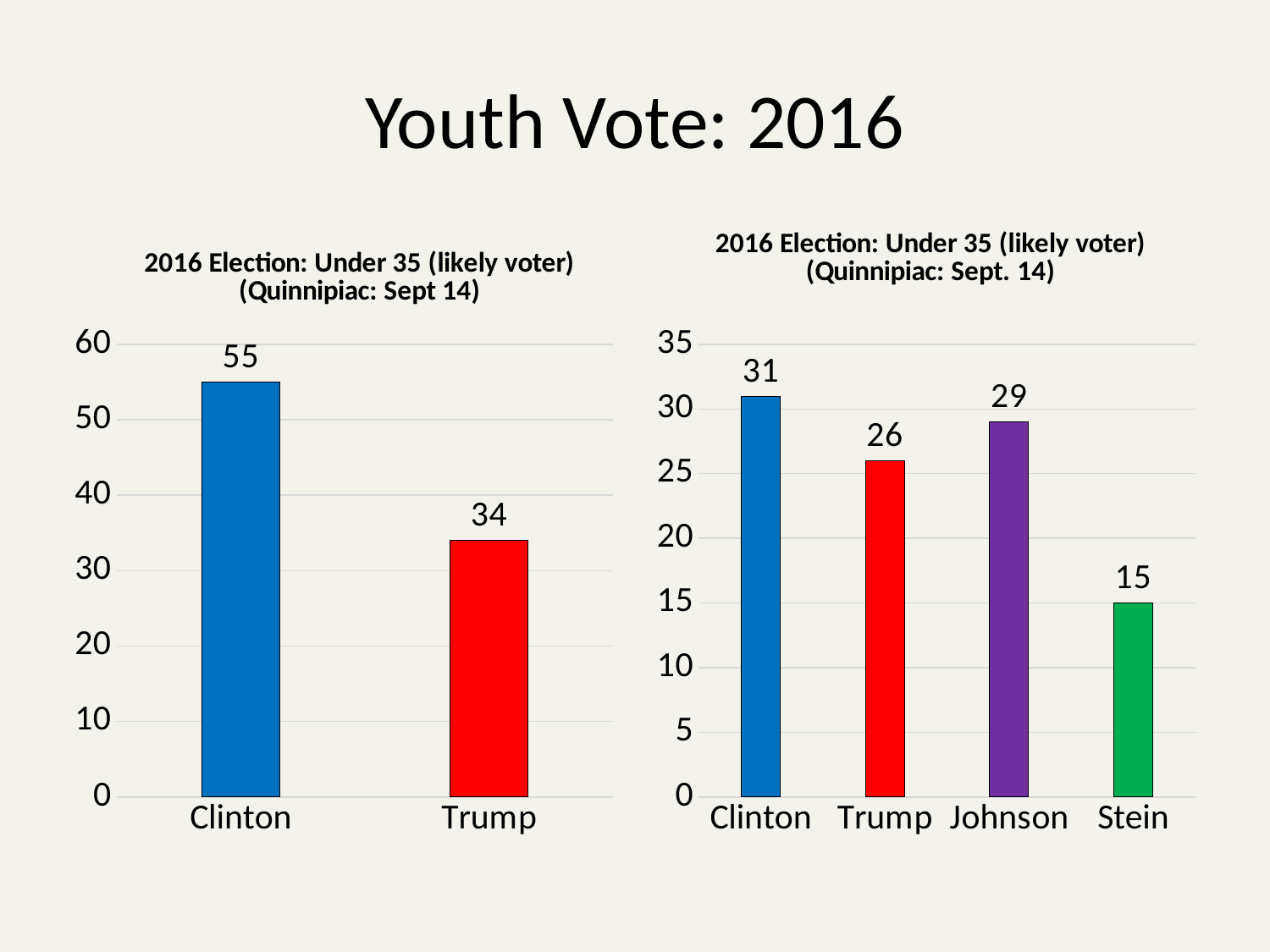
In the right chart, which candidate has the highest value? Clinton In the right chart, what colour is the bar for Johnson? Purple In the left chart, what is the value for Trump? 34 In the right chart, what is the value for Johnson? 29 What kind of chart is the left chart? Bar chart In the right chart, which is larger, the value for Trump or the value for Johnson? Johnson In the right chart, what is the value for Stein? 15 In the right chart, which candidate has the lowest value? Stein How many candidates are shown in the right chart? 4 In the left chart, what is the difference between Clinton's and Trump's values? 21 In the left chart, what is the value for Clinton? 55 In the right chart, what is the difference between Clinton's and Trump's values? 5